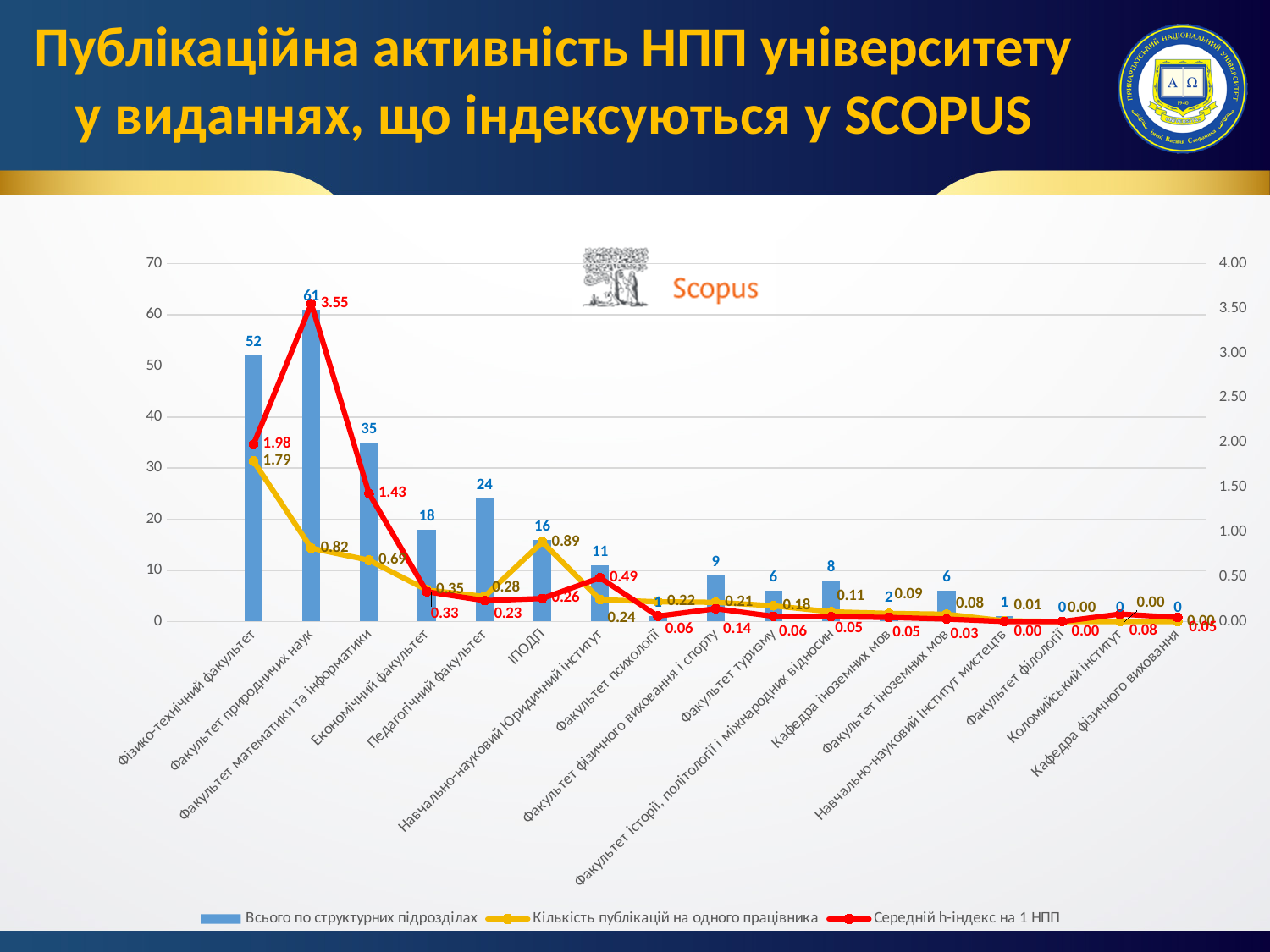
Which unit has the highest total number of publications? Факультет природничих наук What is the number of publications per employee (Кількість публікацій на одного працівника) for Фізико-технічний факультет? 1.79 What kind of chart is shown on the slide? Combined bar and line chart How many structural units (categories) are shown on the x axis? 17 Which has more total publications: Педагогічний факультет or Факультет математики та інформатики? Факультет математики та інформатики What is the average h-index (Середній h-індекс на 1 НПП) for Факультет природничих наук? 3.55 What is the total number of publications (Всього по структурних підрозділах) for Фізико-технічний факультет? 52 What is the difference in total publications between Факультет природничих наук and Фізико-технічний факультет? 9 How many series does the legend list? 3 Which unit has the highest average h-index per НПП? Факультет природничих наук What is the total number of publications for Факультет математики та інформатики? 35 What is the average h-index for Факультет математики та інформатики? 1.43